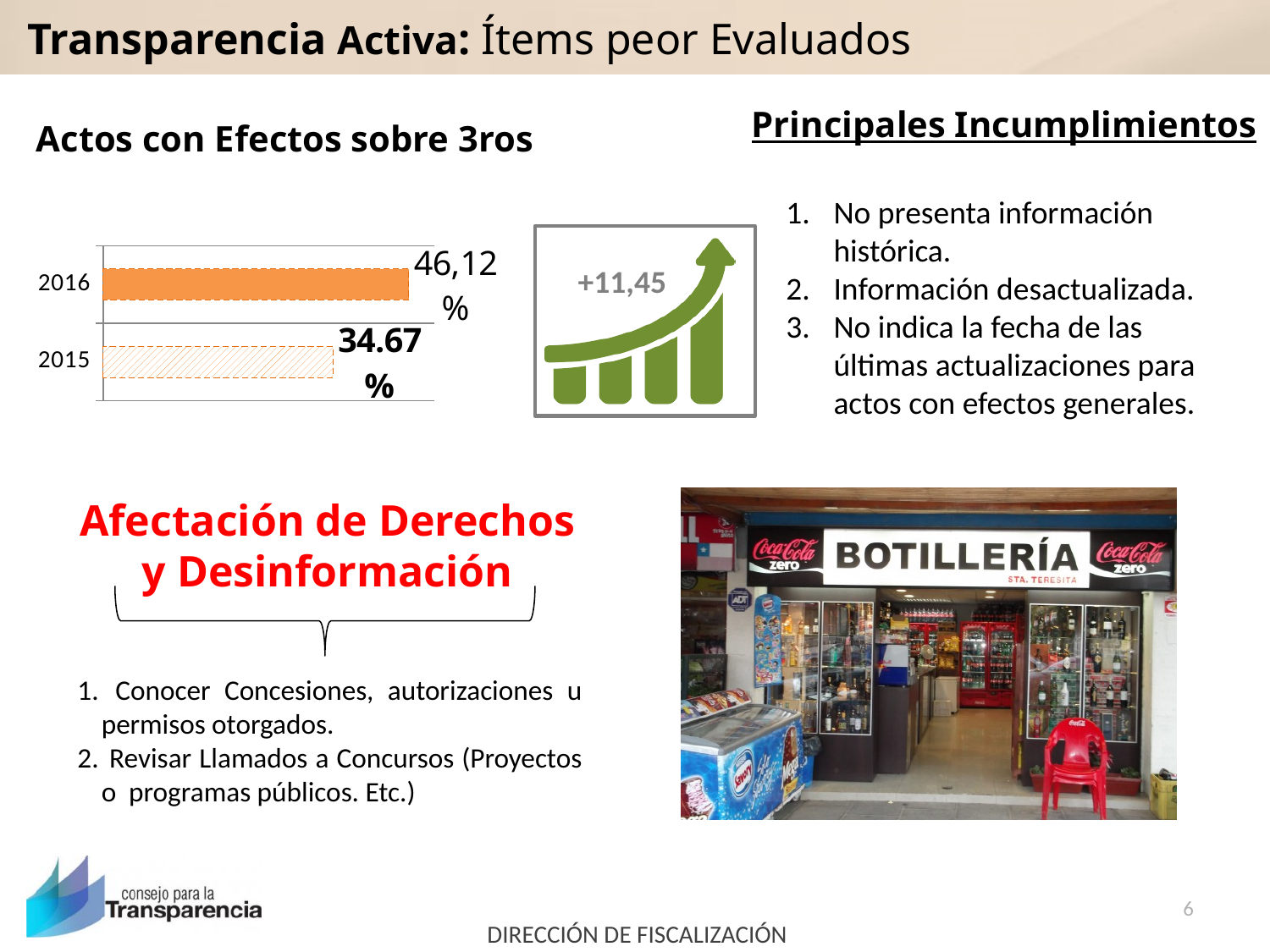
What is the value for 2015 in the 'Actos con Efectos sobre 3ros' chart? 34.67 % What colour is the 2016 bar in the 'Actos con Efectos sobre 3ros' chart? orange By how many percentage points does the 2016 value exceed the 2015 value in the 'Actos con Efectos sobre 3ros' chart? 11,45 What kind of chart is used for 'Actos con Efectos sobre 3ros'? bar chart Which year has the lower value in the 'Actos con Efectos sobre 3ros' chart? 2015 Which year has the higher value in the 'Actos con Efectos sobre 3ros' chart? 2016 How many years are plotted in the 'Actos con Efectos sobre 3ros' chart? 2 What change figure is shown next to the 'Actos con Efectos sobre 3ros' chart in the green growth icon? +11,45 Did the value in the 'Actos con Efectos sobre 3ros' chart rise or fall from 2015 to 2016? rise What is the value for 2016 in the 'Actos con Efectos sobre 3ros' chart? 46,12 % Is the value for 2016 larger or smaller than the value for 2015 in the 'Actos con Efectos sobre 3ros' chart? larger